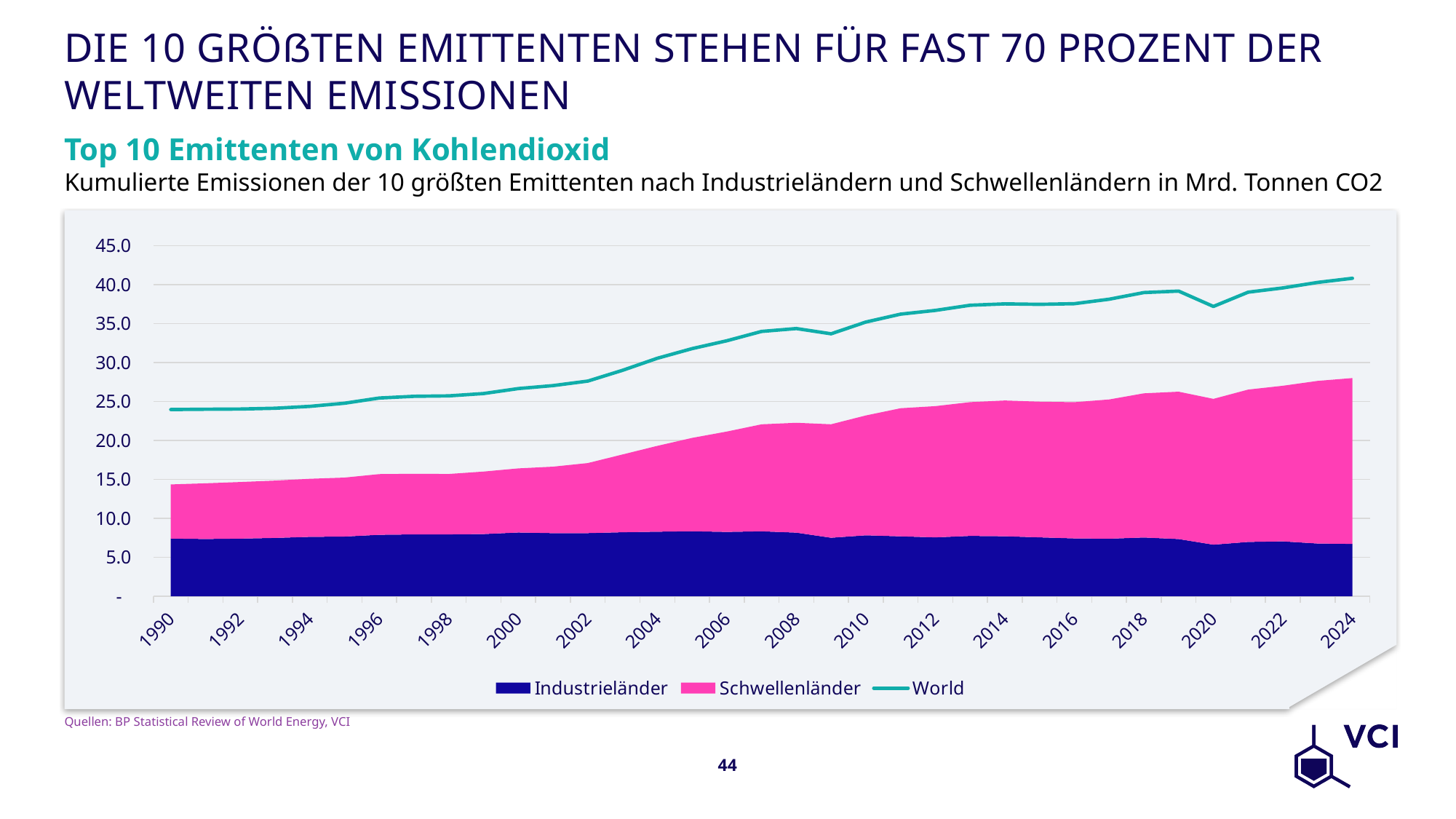
Is the World value for 2020 greater or less than 40.0? less Is the World value for 2000 greater or less than 25.0? greater Which series are listed in the legend? Industrieländer, Schwellenländer, World Is the World value for 2024 greater or less than 35.0? greater How many years are labelled on the x axis? 18 How many series does the legend list? 3 What is the title of the chart? Top 10 Emittenten von Kohlendioxid What kind of chart is shown on the slide? Stacked area chart with a line In which year does the World line reach its highest value? 2024 Which is larger, the World value for 2019 or for 2020? 2019 Does the World line rise or fall from 1990 to 2024? Rises